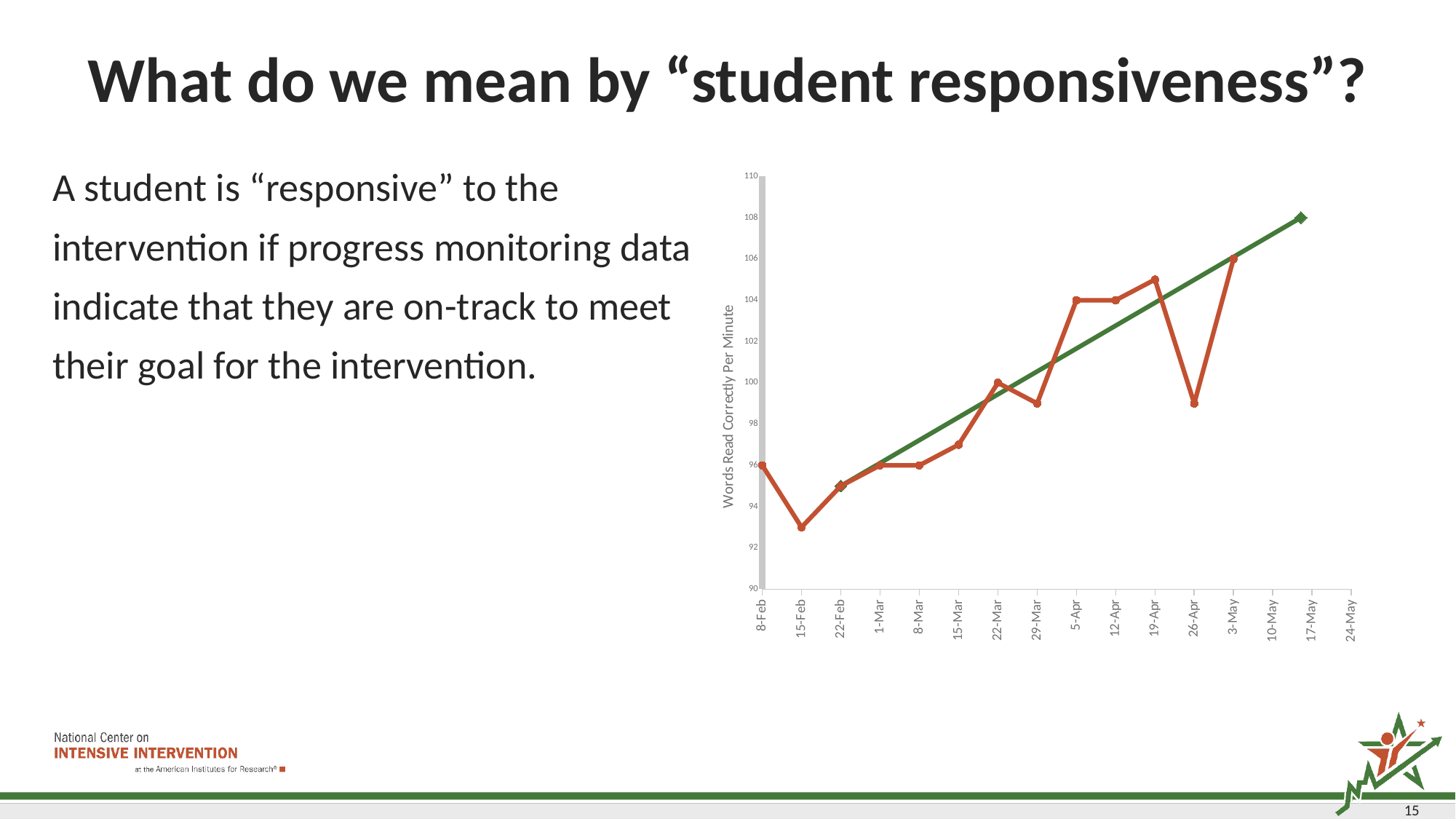
What kind of chart is shown on the slide? line chart On which date does the red line reach its highest value? 3-May How many dates are labelled along the x axis of the chart? 16 What is the label on the vertical axis of the chart? Words Read Correctly Per Minute Which has the larger value on the red line, 5-Apr or 26-Apr? 5-Apr On which date is the red line at its lowest value? 15-Feb What is the value of the red line on 8-Feb? 96 Overall, does the red line rise or fall from 8-Feb to 3-May? rise Is the value of the red line on 26-Apr greater or less than 100? less What value does the green goal line reach at its end point on 17-May? 108 Is the value of the red line on 15-Feb greater or less than 94? less What is the value of the red line on 22-Mar? 100